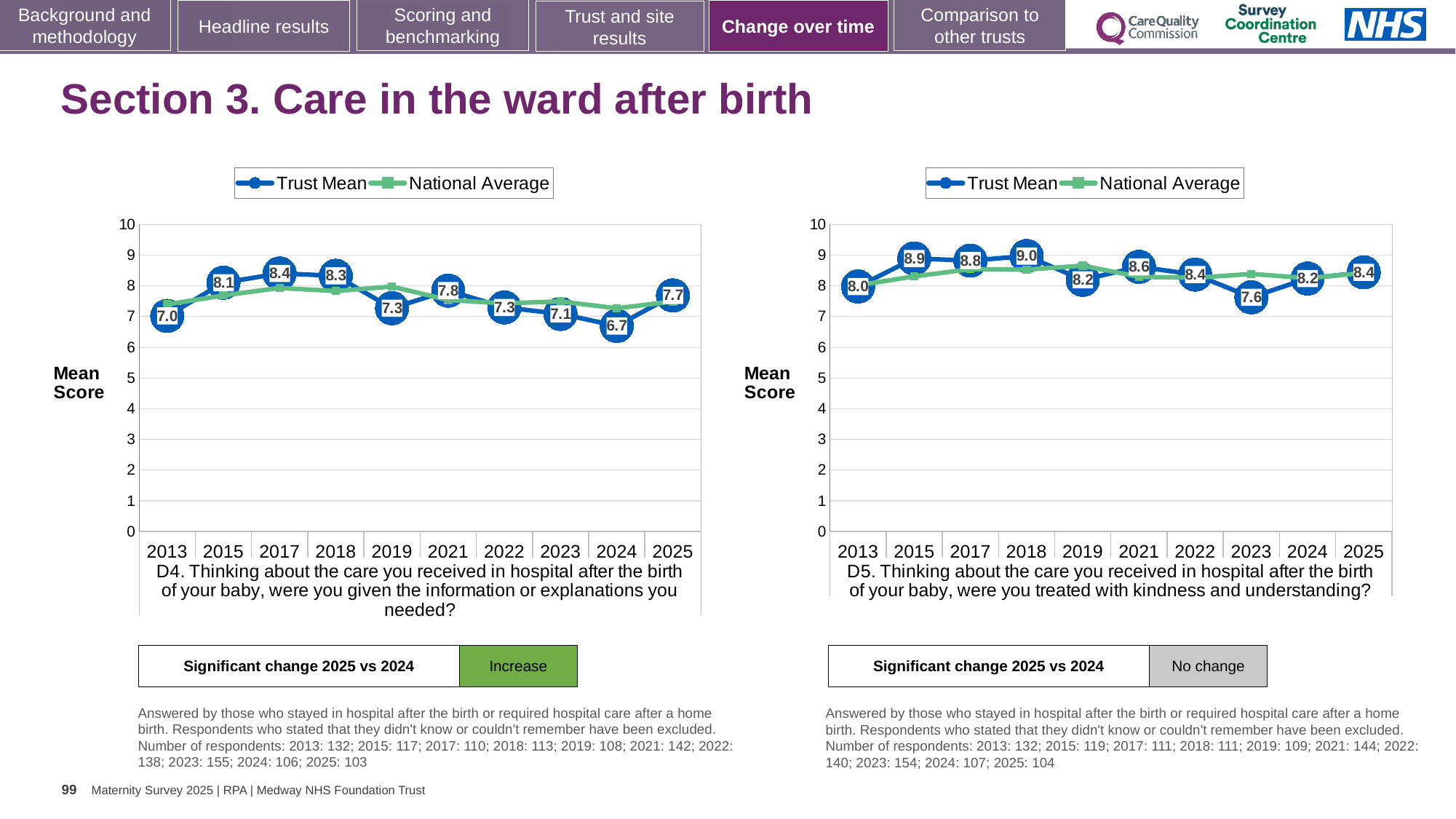
In the D4 chart on the left, what is the Trust Mean for 2024? 6.7 In the D4 chart on the left, which year has the highest Trust Mean? 2017 What type of chart is the D4 chart on the left? Line chart How many years are plotted on the x axis of the D4 chart on the left? 10 In the D5 chart on the right, what is the difference between the Trust Mean in 2018 and in 2023? 1.4 In the D5 chart on the right, what is the Trust Mean for 2018? 9.0 How many series does the legend of the D5 chart on the right list? 2 In the D5 chart on the right, which year has the lowest Trust Mean? 2023 In the D5 chart on the right, is the Trust Mean higher in 2015 or in 2019? 2015 In the D4 chart on the left, what is the difference between the Trust Mean in 2025 and in 2024? 1.0 In the D4 chart on the left, what is the Trust Mean for 2025? 7.7 In the D4 chart on the left, which year has the lowest Trust Mean? 2024